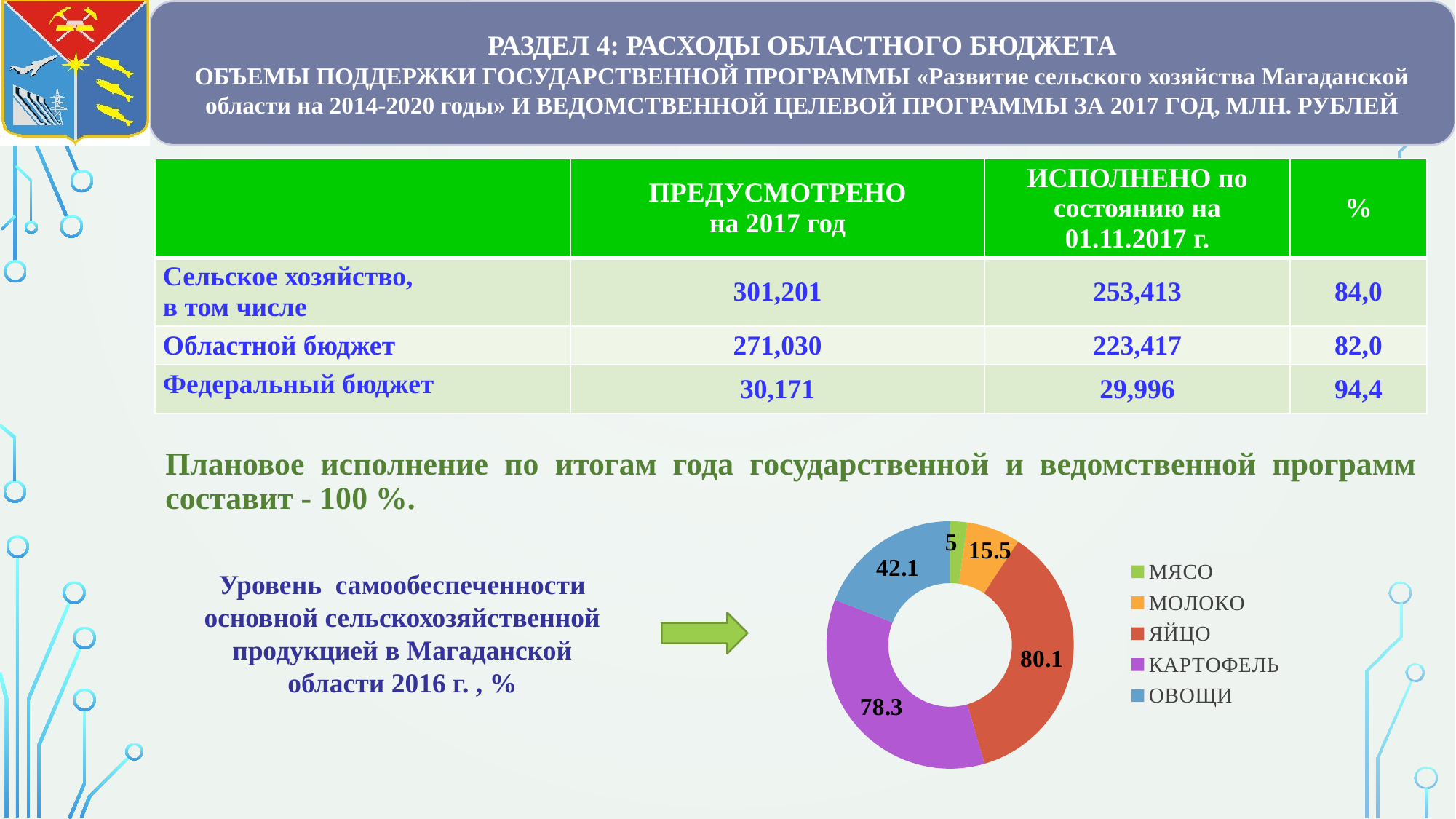
What is the difference between the values for ЯЙЦО and КАРТОФЕЛЬ in the doughnut chart? 1.8 In the doughnut chart, what is the value for МОЛОКО? 15.5 In the doughnut chart, what is the value for ОВОЩИ? 42.1 Which colour represents КАРТОФЕЛЬ in the doughnut chart? Purple Which category has the highest value in the doughnut chart? ЯЙЦО In the doughnut chart, what is the value for КАРТОФЕЛЬ? 78.3 In the doughnut chart, what is the value for ЯЙЦО? 80.1 How many categories does the legend of the doughnut chart list? 5 Which category has the lowest value in the doughnut chart? МЯСО What kind of chart is shown on the slide? Doughnut (pie) chart In the doughnut chart, what is the value for МЯСО? 5 What is the difference between the values for ОВОЩИ and МОЛОКО in the doughnut chart? 26.6